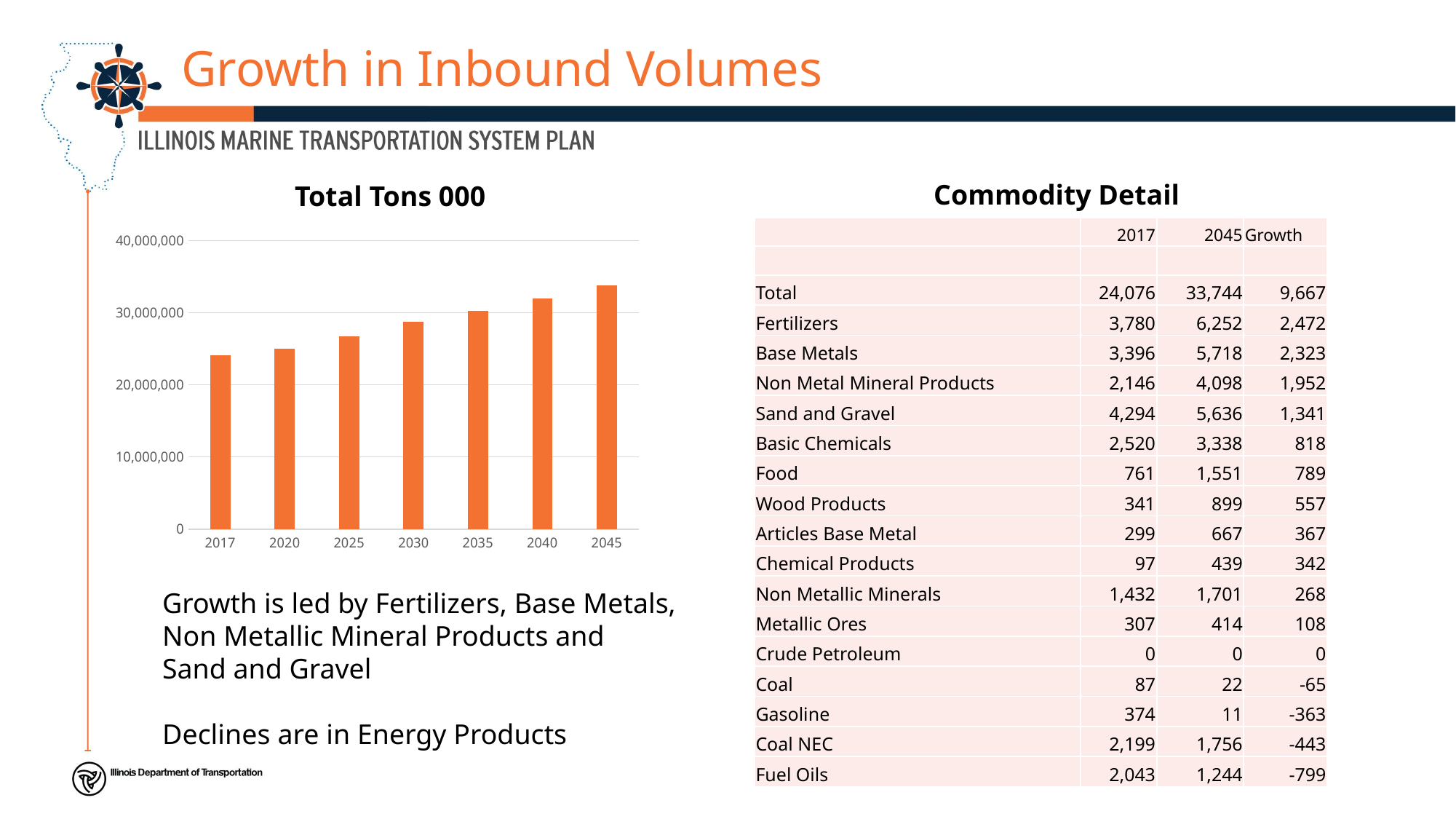
In the "Total Tons 000" chart, is the value for 2040 greater or less than 30,000,000? greater In the "Total Tons 000" chart, which is larger, the value for 2020 or the value for 2040? 2040 How many years are plotted on the x axis of the "Total Tons 000" chart? 7 What is the title of the bar chart on the left of the slide? Total Tons 000 What is the highest value labelled on the vertical axis of the "Total Tons 000" chart? 40,000,000 In the "Total Tons 000" chart, is the value for 2017 greater or less than 20,000,000? greater In the "Total Tons 000" chart, do the values rise or fall from 2017 to 2045? rise In the "Total Tons 000" chart, which year has the lowest bar? 2017 In the "Total Tons 000" chart, is the value for 2045 greater or less than 30,000,000? greater What kind of chart is shown under the title "Total Tons 000"? bar chart In the "Total Tons 000" chart, which year has the highest bar? 2045